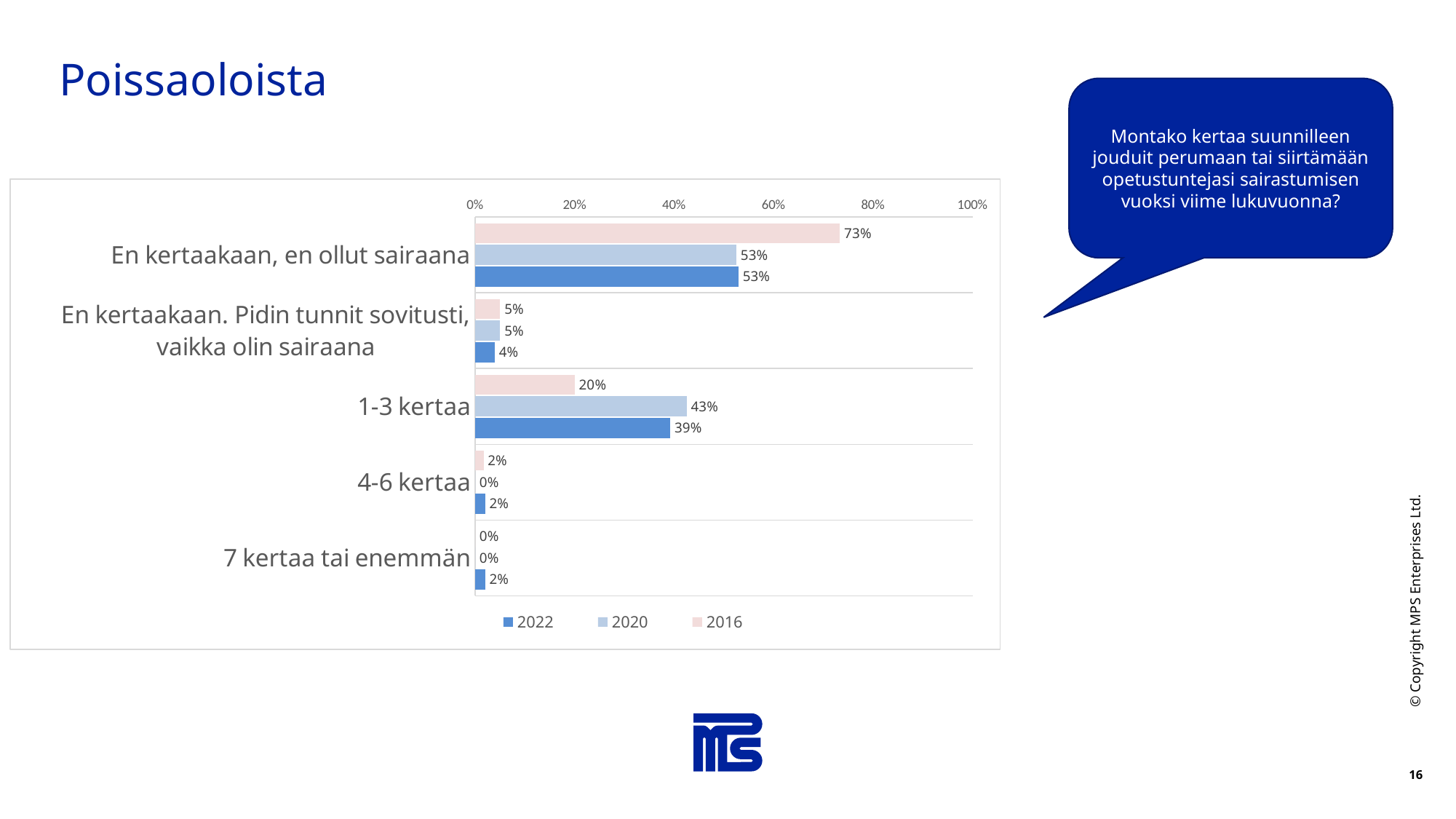
How many categories are shown on the chart? 5 For "1-3 kertaa", which series has the larger value, 2020 or 2016? 2020 What kind of chart is shown on the slide? Bar chart What is the 2016 value for "En kertaakaan, en ollut sairaana"? 73% What is the 2022 value for "En kertaakaan. Pidin tunnit sovitusti, vaikka olin sairaana"? 4% How many series does the legend list? 3 What is the 2022 value for "1-3 kertaa"? 39% What is the difference between the 2016 and 2022 values for "En kertaakaan, en ollut sairaana"? 20% Which category has the lowest 2016 value? 7 kertaa tai enemmän Which category has the highest 2016 value? En kertaakaan, en ollut sairaana What is the 2020 value for "1-3 kertaa"? 43% What is the difference between the 2020 and 2016 values for "1-3 kertaa"? 23%